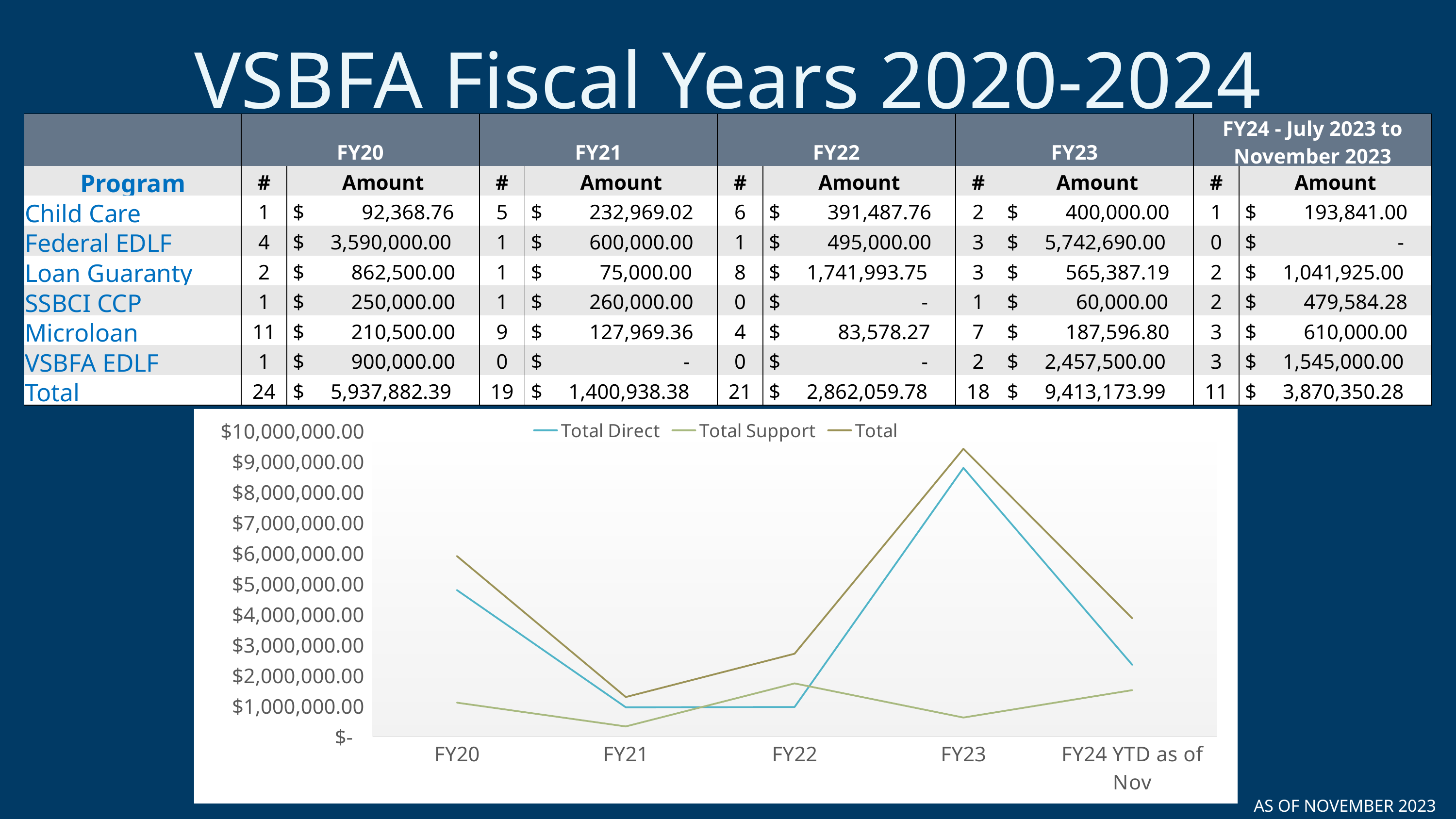
Is the Total Support value for FY21 greater or less than $1,000,000.00? less Does the Total line rise or fall from FY22 to FY23? rise Is the Total Direct value for FY23 greater or less than $8,000,000.00? greater What kind of chart is shown on the slide? line chart In which fiscal year does the Total line reach its highest point? FY23 How many series does the chart legend list? 3 Which series is drawn in green in the chart legend? Total Support Which is larger, the Total Direct value for FY20 or for FY24 YTD as of Nov? FY20 In which fiscal year is the Total line at its lowest point? FY21 Is the Total Direct value for FY24 YTD as of Nov greater or less than $3,000,000.00? less In which fiscal year is the Total Support line at its lowest point? FY21 How many fiscal year categories are plotted along the x axis of the chart? 5